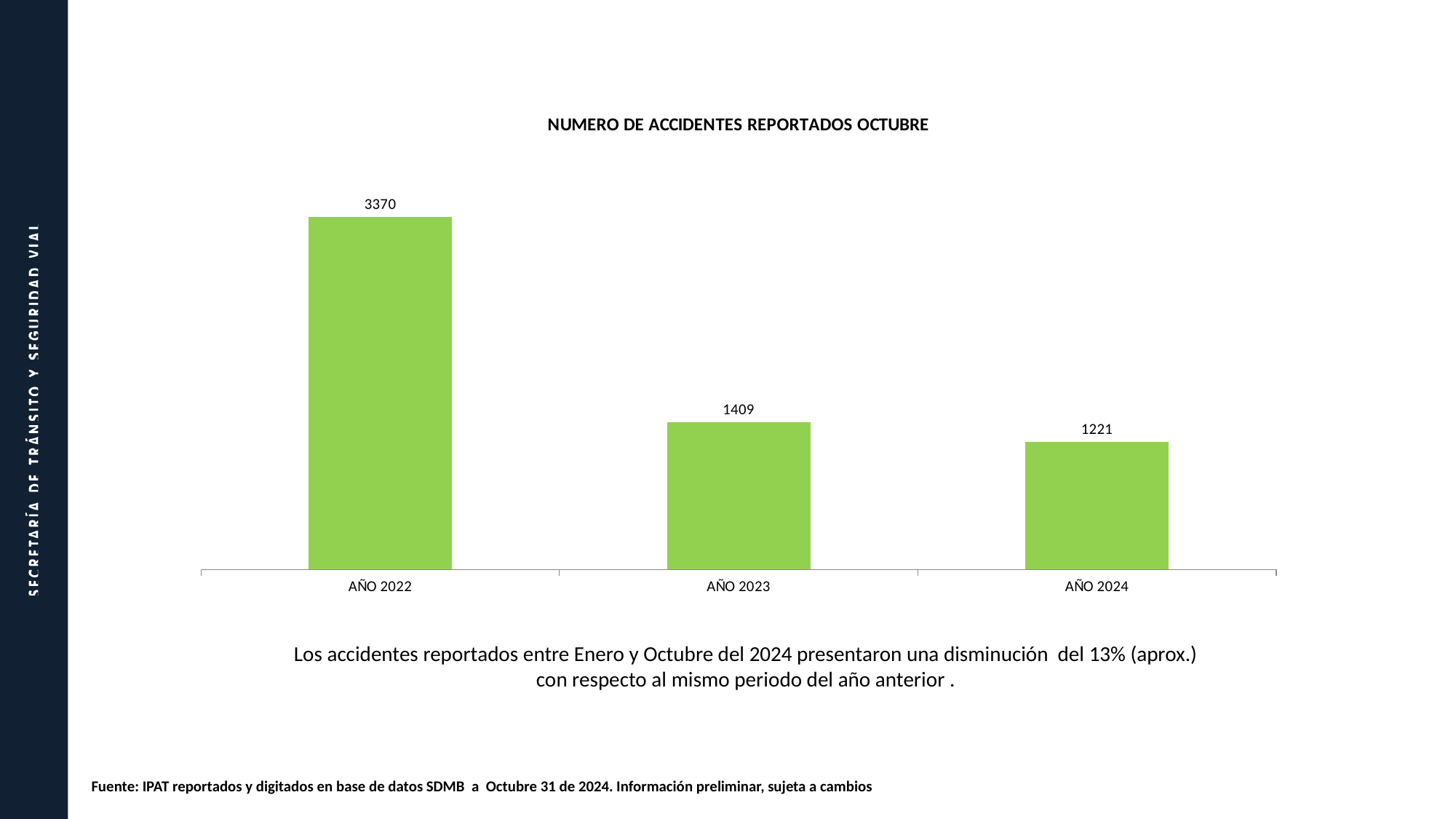
How many years are shown in the chart? 3 Which year has the lowest number of accidents reported? AÑO 2024 What is the number of accidents reported for AÑO 2024? 1221 What kind of chart is shown on the slide? Bar chart What is the title of the chart? NUMERO DE ACCIDENTES REPORTADOS OCTUBRE Which year has the highest number of accidents reported? AÑO 2022 What is the difference between the values for AÑO 2022 and AÑO 2023? 1961 What is the number of accidents reported for AÑO 2023? 1409 What is the number of accidents reported for AÑO 2022? 3370 What is the difference between the values for AÑO 2023 and AÑO 2024? 188 Which is larger, the value for AÑO 2023 or AÑO 2024? AÑO 2023 Do the values rise or fall from AÑO 2022 to AÑO 2024? Fall